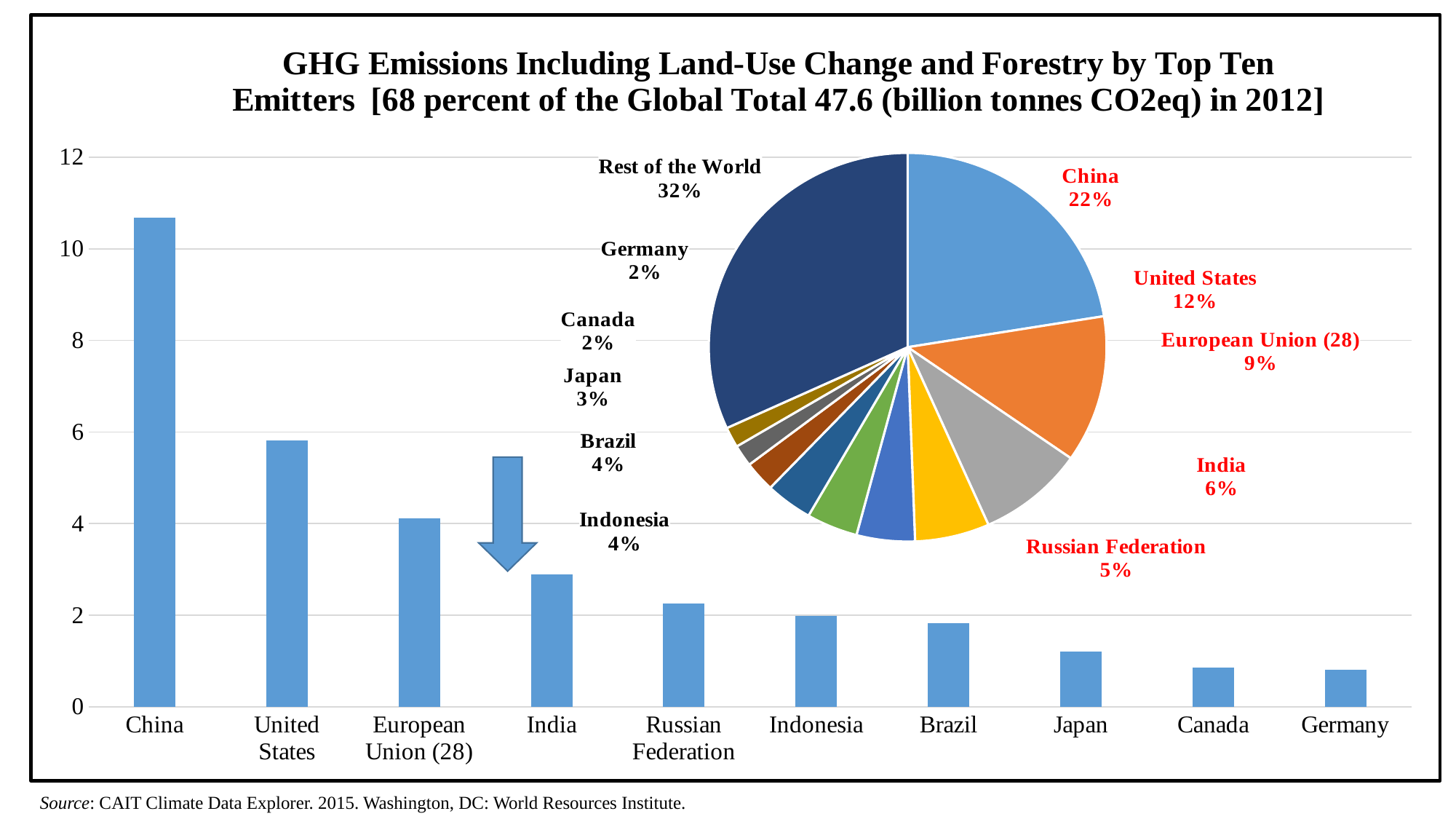
In the bar chart, is the value for Japan greater or less than 2? less How many countries or regions are shown in the bar chart? 10 What type of chart is on the right side of the slide? pie chart In the bar chart, is the value for India greater or less than 4? less In the pie chart, what share does the Rest of the World have? 32% What type of chart is on the left side of the slide? bar chart In the bar chart, which country has the lowest emissions? Germany In the pie chart, what share does China have? 22% In the bar chart, which country has the highest emissions? China In the pie chart, what is the difference in percentage points between China and the United States? 10 In the bar chart, is the value for China greater or less than 10? greater How many slices does the pie chart have? 11